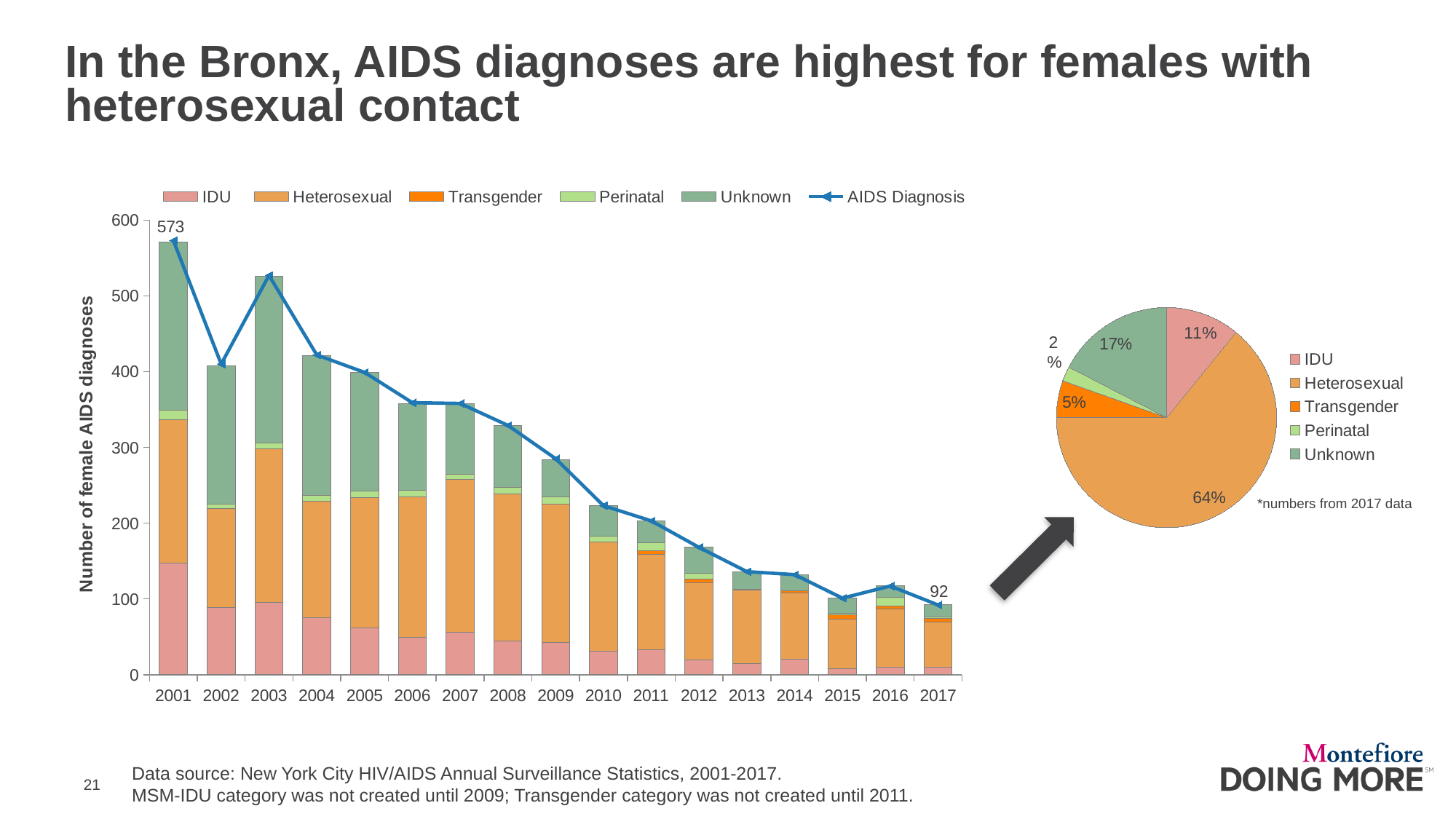
In the pie chart on the right, what is the difference between the Unknown and IDU shares? 6% In the bar chart on the left, is the AIDS Diagnosis value for 2012 greater or less than 200? less In the pie chart on the right, which category has the smallest slice? Perinatal In the bar chart on the left, how many entries does the legend list? 6 In the bar chart on the left, which year has the highest number of female AIDS diagnoses? 2001 In the bar chart on the left, what is the AIDS Diagnosis value labelled for 2001? 573 In the bar chart on the left, do the AIDS Diagnosis values generally rise or fall from 2001 to 2017? fall In the bar chart on the left, how many years are shown on the x axis? 17 According to the note next to the pie chart on the right, which year's data does the pie chart use? 2017 In the pie chart on the right, what share is Heterosexual? 64% In the bar chart on the left, what is the AIDS Diagnosis value labelled for 2017? 92 In the bar chart on the left, what is the difference between the labelled AIDS Diagnosis values for 2001 and 2017? 481